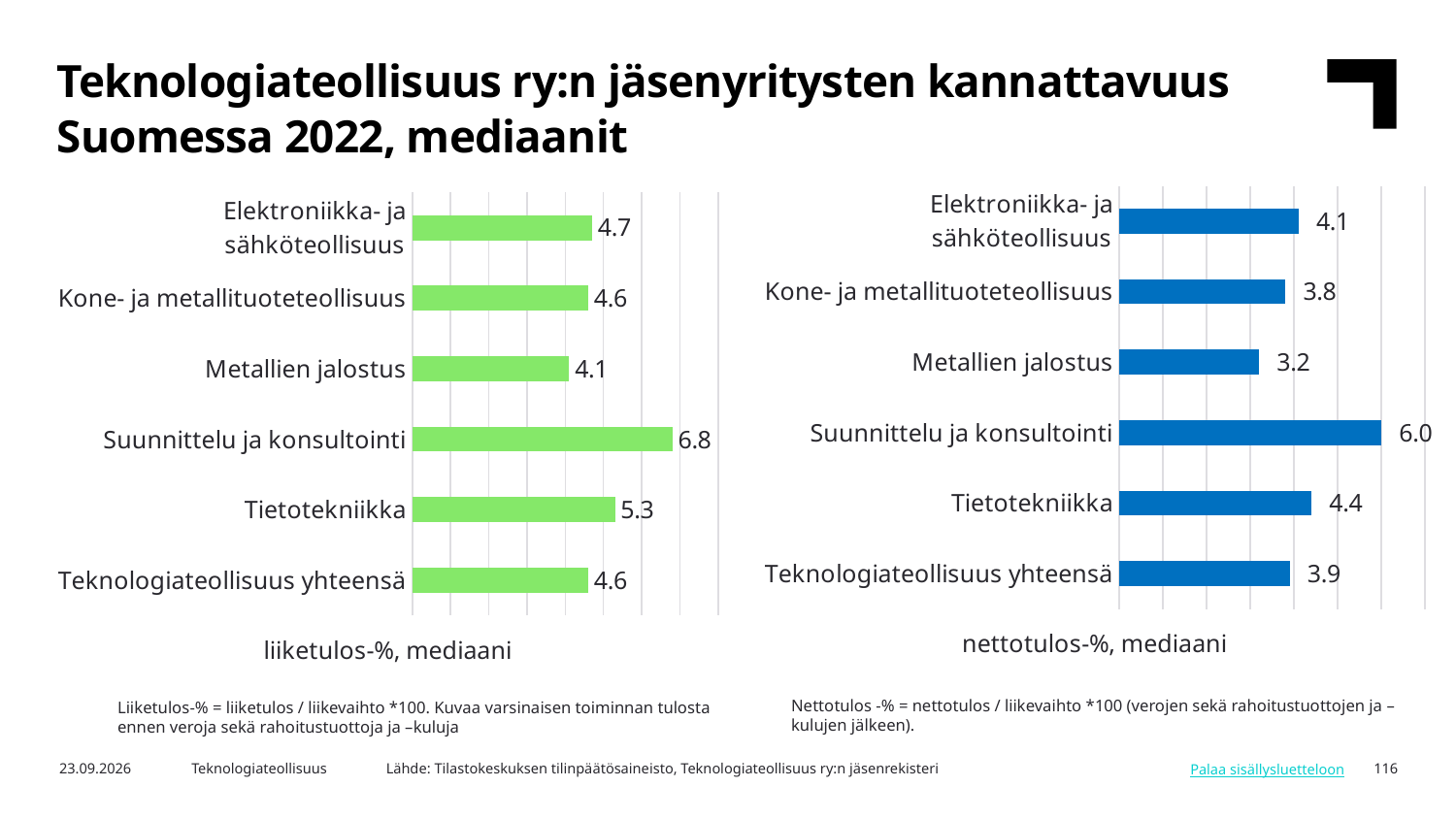
In the left chart (liiketulos-%, mediaani), what is the difference between Suunnittelu ja konsultointi and Tietotekniikka? 1.5 In the left chart (liiketulos-%, mediaani), what is the value for Metallien jalostus? 4.1 How many categories are shown in the left chart (liiketulos-%, mediaani)? 6 In the left chart (liiketulos-%, mediaani), what is the value for Suunnittelu ja konsultointi? 6.8 In the right chart (nettotulos-%, mediaani), which category has the lowest value? Metallien jalostus What kind of chart is the right chart (nettotulos-%, mediaani)? Bar chart What colour are the bars in the left chart (liiketulos-%, mediaani)? Green In the right chart (nettotulos-%, mediaani), which is larger: Tietotekniikka or Teknologiateollisuus yhteensä? Tietotekniikka In the right chart (nettotulos-%, mediaani), what is the value for Teknologiateollisuus yhteensä? 3.9 In the right chart (nettotulos-%, mediaani), what is the difference between Suunnittelu ja konsultointi and Elektroniikka- ja sähköteollisuus? 1.9 In the left chart (liiketulos-%, mediaani), which category has the highest value? Suunnittelu ja konsultointi In the right chart (nettotulos-%, mediaani), what is the value for Metallien jalostus? 3.2